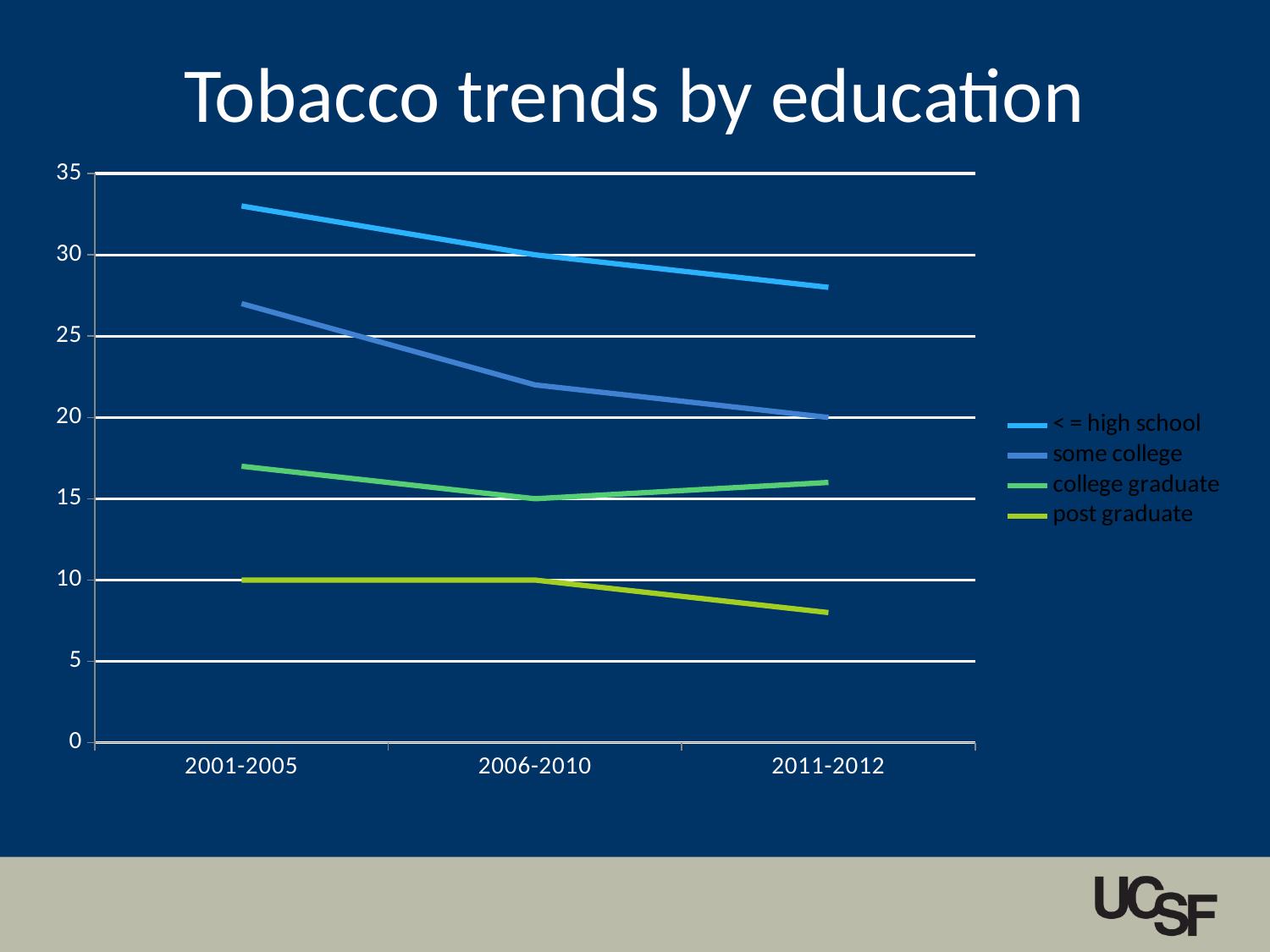
Is the value for < = high school in 2001-2005 greater or less than 30? greater What kind of chart is shown on the slide? line chart What is the value for post graduate in 2001-2005? 10 Is the value for post graduate in 2011-2012 greater or less than 10? less How many time periods are shown on the x axis? 3 Does the < = high school line rise or fall from 2001-2005 to 2011-2012? fall What is the value for college graduate in 2006-2010? 15 How many series does the legend list? 4 Which education group has the lowest values across all periods? post graduate In 2011-2012, which is larger: the value for some college or the value for college graduate? some college Which education group has the highest values across all periods? < = high school What is the value for some college in 2011-2012? 20